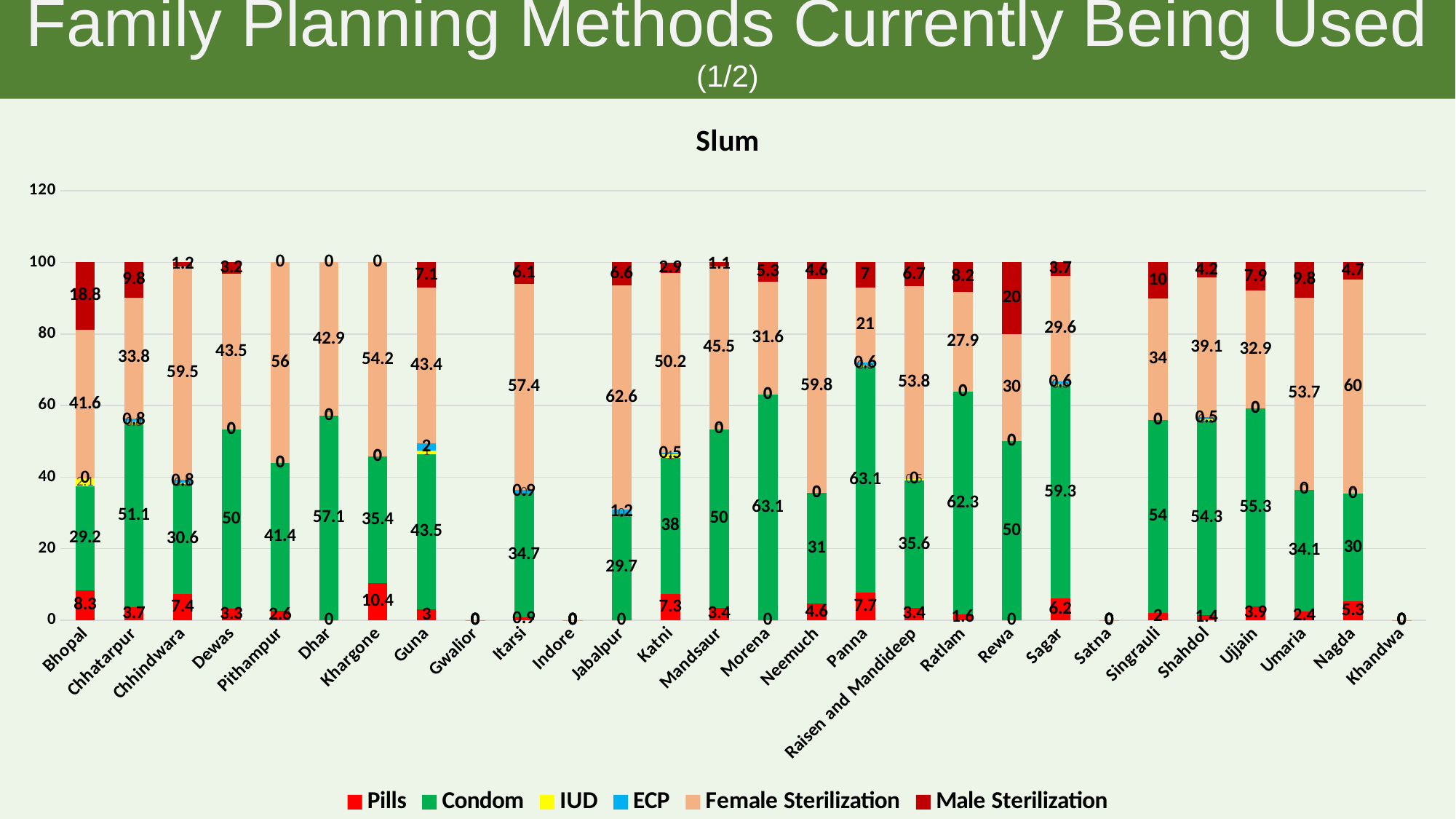
What is the Pills value for Bhopal? 8.3 What is the difference between the Condom values for Dhar and Pithampur? 15.7 Which city has the highest Pills value? Khargone What is the Female Sterilization value for Nagda? 60 What is the Condom value for Morena? 63.1 Which has the larger Condom value, Ratlam or Sagar? Ratlam How many cities are shown on the x axis? 28 What is the Male Sterilization value for Rewa? 20 What kind of chart is shown on the slide? Stacked bar chart Which city has the highest Male Sterilization value? Rewa What is the title of the chart? Slum How many series does the legend list? 6